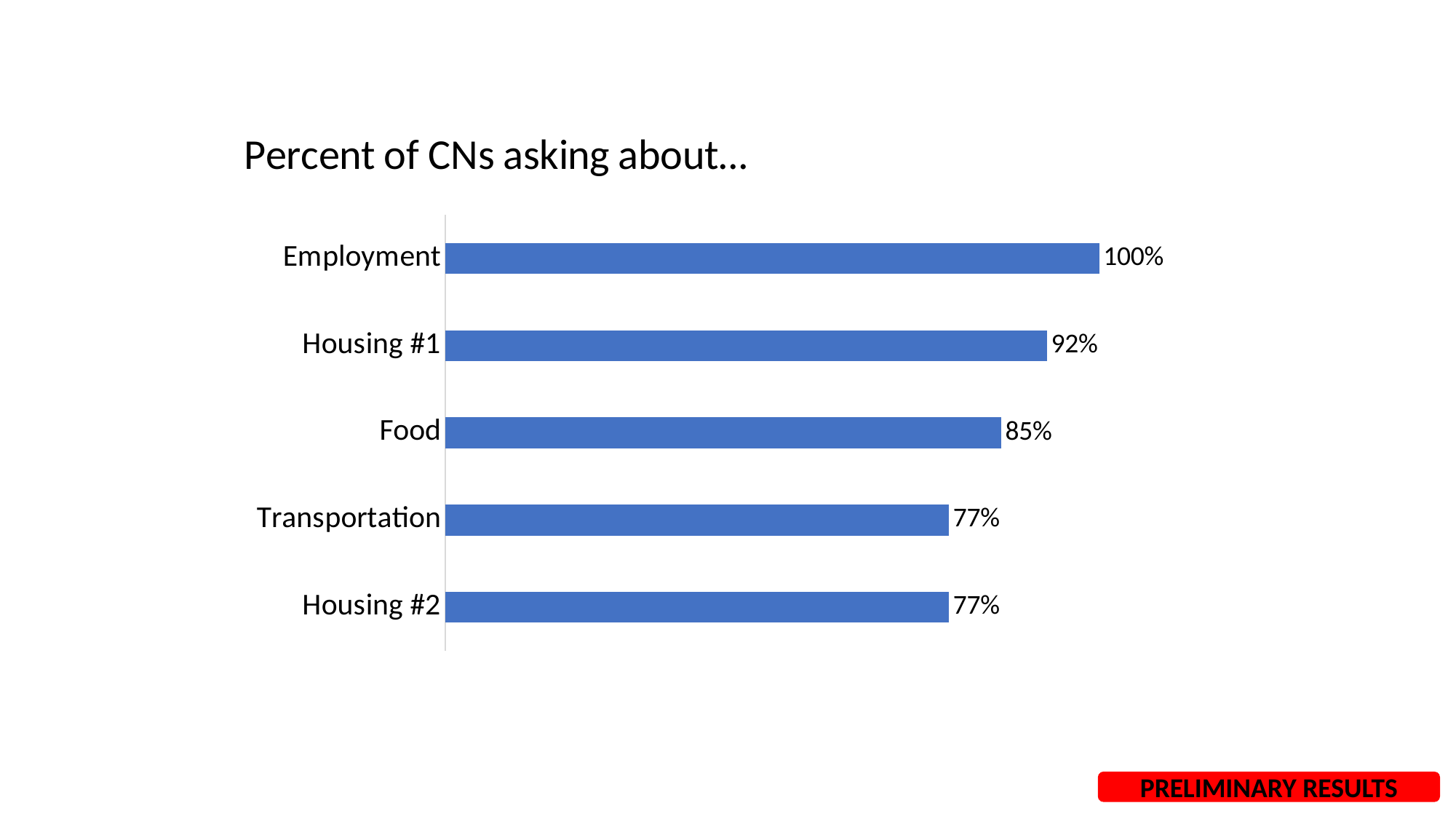
What percent of CNs asked about Employment? 100% What kind of chart is shown on the slide? Bar chart What percent of CNs asked about Housing #1? 92% What is the difference between the Food and Transportation percentages? 8% Which category has the highest percent of CNs asking about it? Employment What percent of CNs asked about Transportation? 77% Which is larger, the value for Housing #1 or the value for Food? Housing #1 What is the difference between the Employment and Housing #1 percentages? 8% Which two categories share the same value of 77%? Transportation and Housing #2 How many categories are shown in the chart? 5 What percent of CNs asked about Food? 85% What is the title of the chart? Percent of CNs asking about…